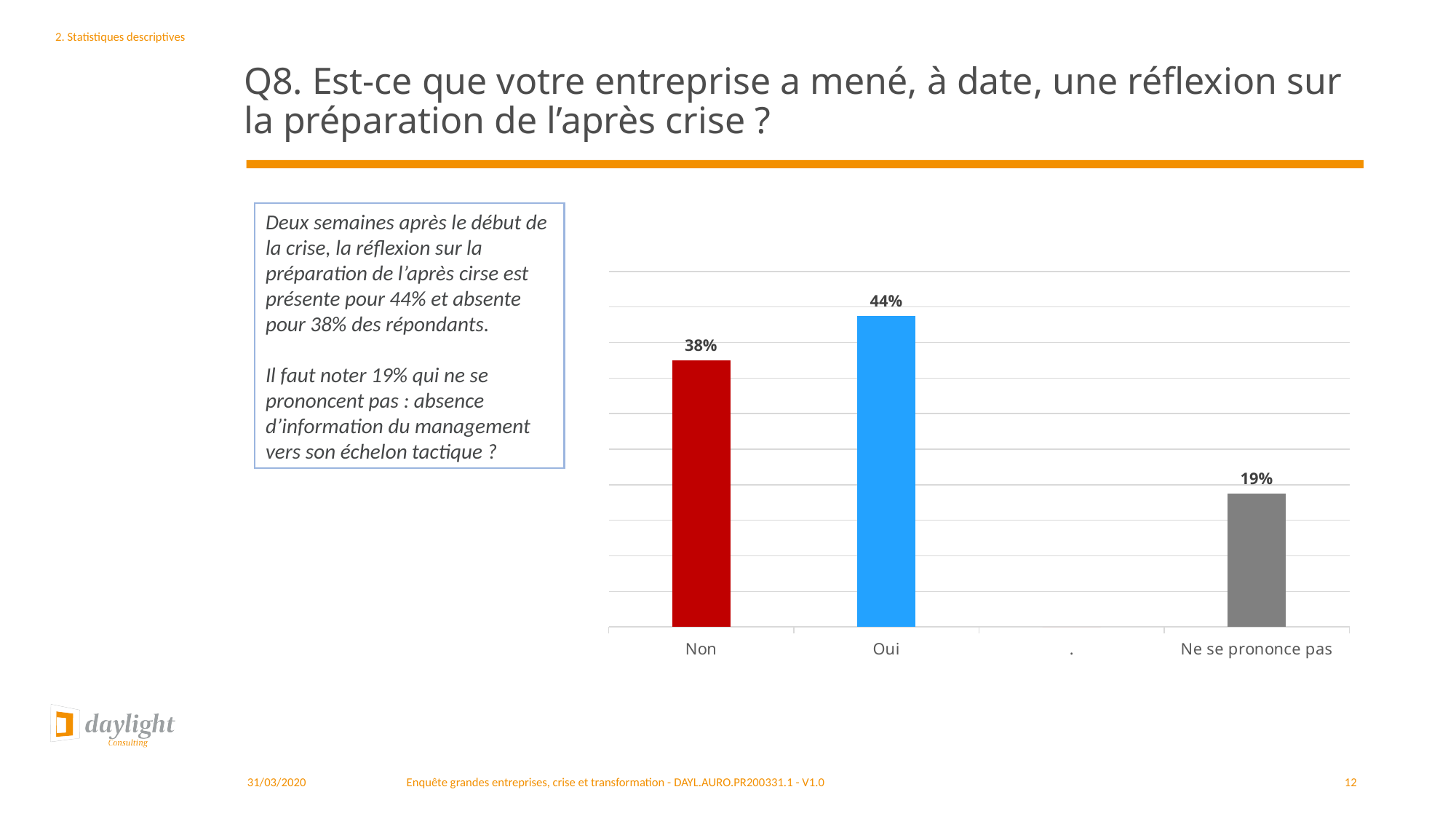
What kind of chart is shown on the slide? Bar chart What colour is the bar for Oui? Blue Which is larger, the value for Ne se prononce pas or the value for Non? Non What is the value for Non? 38% What is the difference between the values for Oui and Non? 6% Which category has the highest value? Oui Which category has the lowest value? Ne se prononce pas What is the value for Oui? 44% What is the value for Ne se prononce pas? 19% What colour is the bar for Non? Red What is the difference between the values for Non and Ne se prononce pas? 19% Which is larger, the value for Non or the value for Oui? Oui